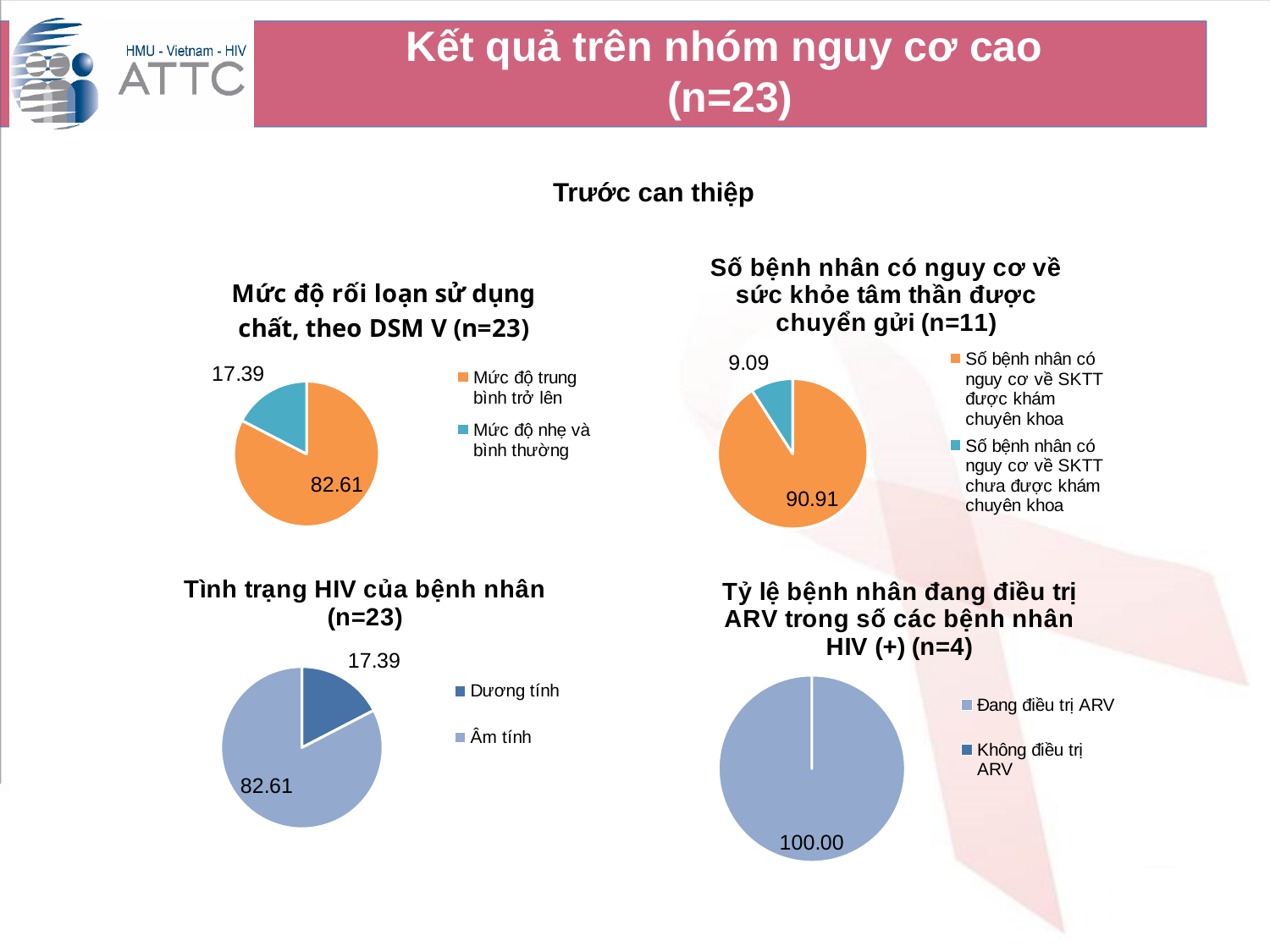
In the chart titled "Tình trạng HIV của bệnh nhân (n=23)", which category is the largest? Âm tính What type of chart is the chart titled "Tình trạng HIV của bệnh nhân (n=23)"? Pie chart In the chart titled "Tỷ lệ bệnh nhân đang điều trị ARV trong số các bệnh nhân HIV (+) (n=4)", what is the value for "Đang điều trị ARV"? 100.00 In the chart titled "Số bệnh nhân có nguy cơ về sức khỏe tâm thần được chuyển gửi (n=11)", what is the value for patients not yet examined by a specialist ("chưa được khám chuyên khoa")? 9.09 In the chart titled "Số bệnh nhân có nguy cơ về sức khỏe tâm thần được chuyển gửi (n=11)", what is the value for patients who were examined by a specialist ("được khám chuyên khoa")? 90.91 In the chart titled "Tình trạng HIV của bệnh nhân (n=23)", what is the value for "Dương tính"? 17.39 In the chart titled "Mức độ rối loạn sử dụng chất, theo DSM V (n=23)", what is the difference between the two slices? 65.22 In the chart titled "Số bệnh nhân có nguy cơ về sức khỏe tâm thần được chuyển gửi (n=11)", which category is the smallest? Số bệnh nhân có nguy cơ về SKTT chưa được khám chuyên khoa How many pie charts are shown on the slide? 4 In the chart titled "Mức độ rối loạn sử dụng chất, theo DSM V (n=23)", what is the value for "Mức độ nhẹ và bình thường"? 17.39 How many entries does the legend of the chart titled "Tỷ lệ bệnh nhân đang điều trị ARV trong số các bệnh nhân HIV (+) (n=4)" list? 2 In the chart titled "Mức độ rối loạn sử dụng chất, theo DSM V (n=23)", what is the value for "Mức độ trung bình trở lên"? 82.61